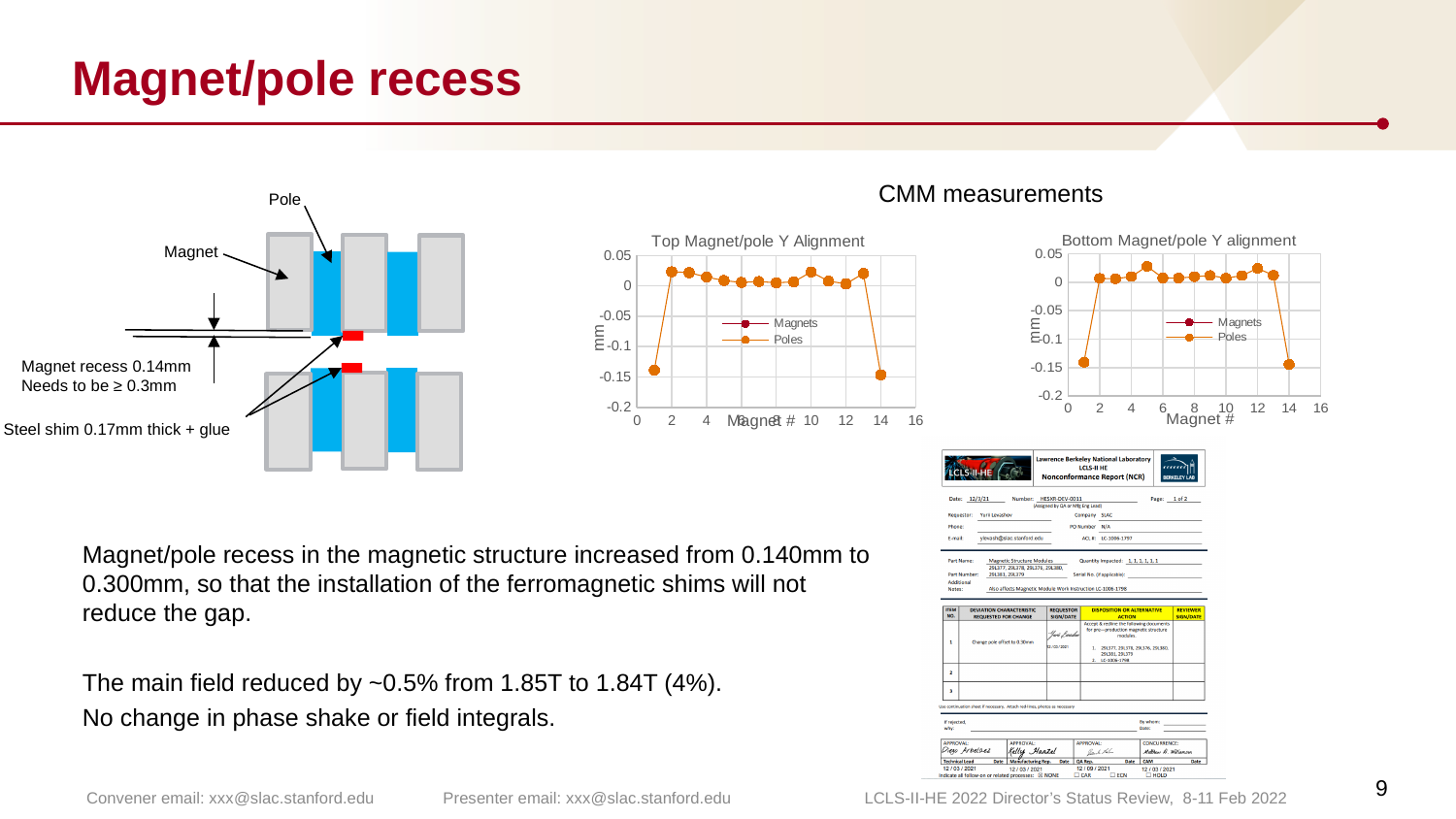
What are the two series named in the legend of the 'Bottom Magnet/pole Y alignment' chart? Magnets and Poles In the 'Bottom Magnet/pole Y alignment' chart, is the value at magnet 1 greater or less than -0.1? less In the 'Top Magnet/pole Y Alignment' chart, is the value at magnet 1 greater or less than -0.1? less What is the highest value shown on the y-axis of the 'Bottom Magnet/pole Y alignment' chart? 0.05 What is the y-axis unit label on the 'Top Magnet/pole Y Alignment' chart? mm In the 'Bottom Magnet/pole Y alignment' chart, which is larger, the value at magnet 5 or the value at magnet 14? magnet 5 In the 'Bottom Magnet/pole Y alignment' chart, is the value at magnet 14 greater or less than -0.1? less In the 'Top Magnet/pole Y Alignment' chart, which is larger, the value at magnet 1 or the value at magnet 8? magnet 8 What kind of chart is the 'Top Magnet/pole Y Alignment' chart? line chart How many series does the legend of the 'Top Magnet/pole Y Alignment' chart list? 2